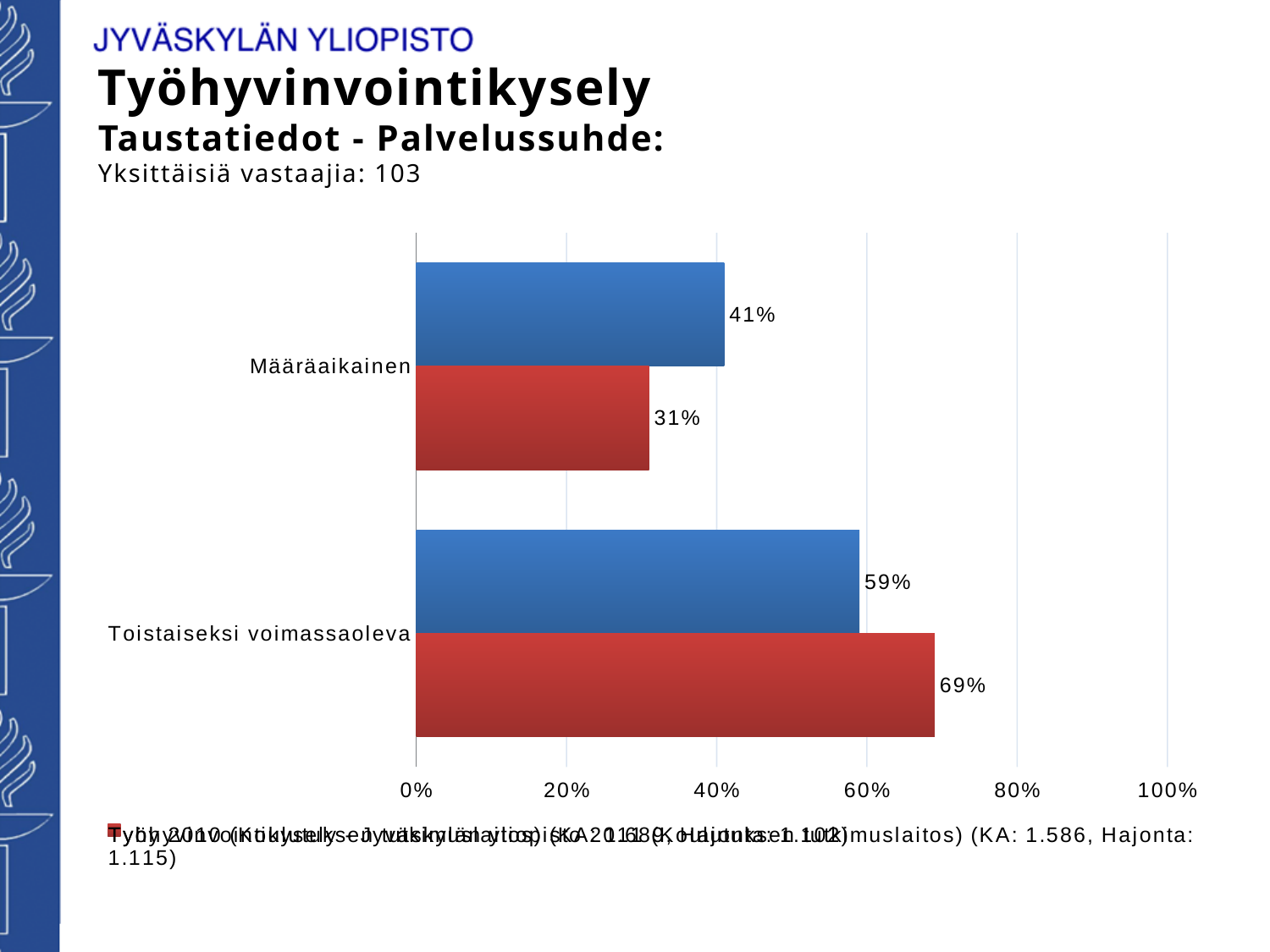
What is the value of the blue bar for Toistaiseksi voimassaoleva? 59% Which category has the lowest blue bar value? Määräaikainen What is the value of the red bar for Toistaiseksi voimassaoleva? 69% What is the difference between the red and blue bar values for Toistaiseksi voimassaoleva? 10% For Määräaikainen, which is larger: the blue bar or the red bar? the blue bar What is the difference between the blue and red bar values for Määräaikainen? 10% How many categories are shown on the chart? 2 How many data series are plotted in the chart? 2 What is the value of the blue bar for Määräaikainen? 41% What is the value of the red bar for Määräaikainen? 31% What kind of chart is shown on the slide? bar chart Which category has the highest red bar value? Toistaiseksi voimassaoleva